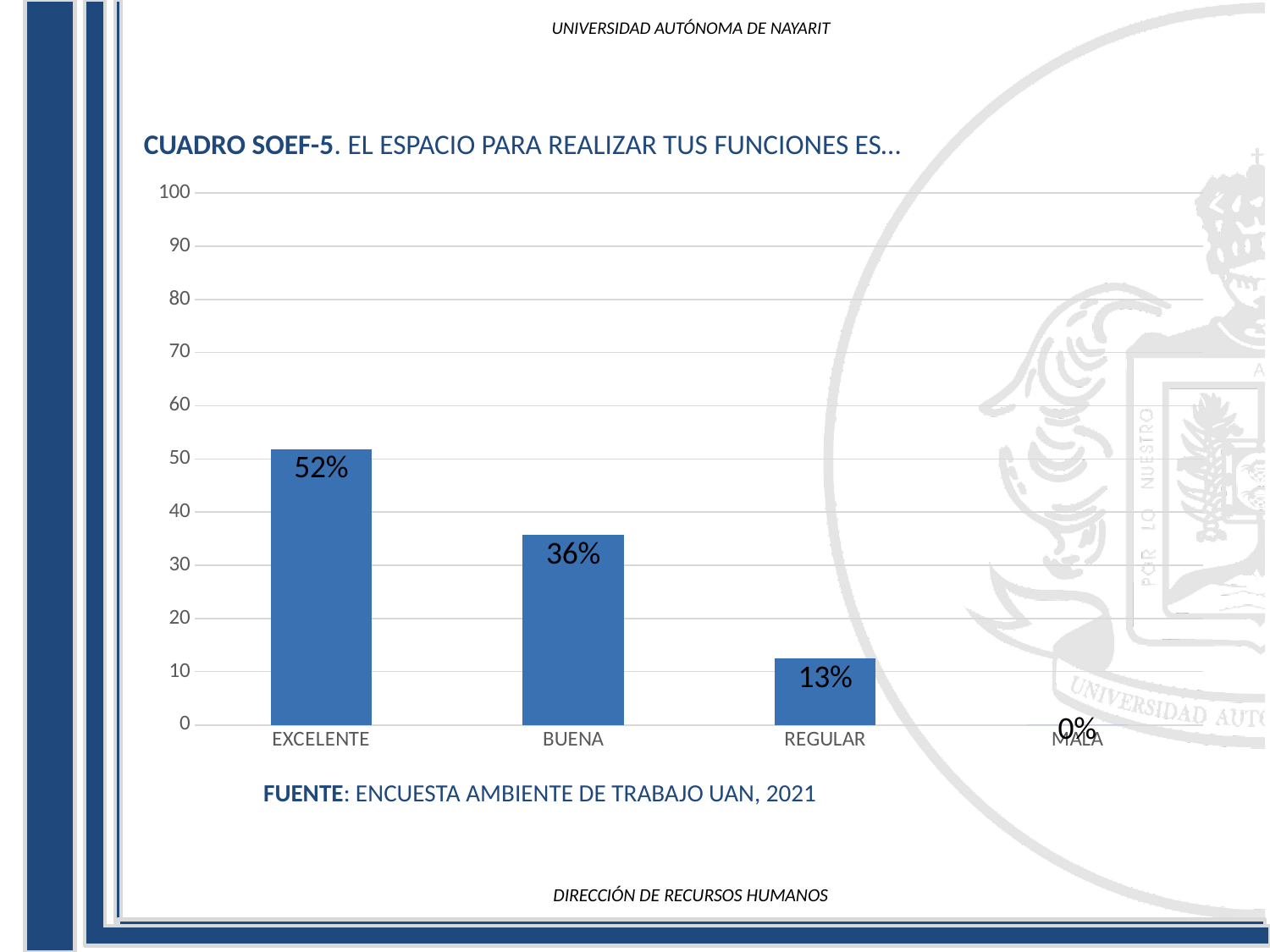
What kind of chart is shown on the slide? bar chart Which is larger, the value for BUENA or the value for REGULAR? BUENA Which category has the lowest value? MALA What is the value for BUENA? 36% What is the value for REGULAR? 13% What is the value for EXCELENTE? 52% Is the value for EXCELENTE greater or less than 50? greater How many categories are shown on the x axis? 4 What is the difference between the values for EXCELENTE and BUENA? 16% Which category has the highest value? EXCELENTE Do the values rise or fall from EXCELENTE to MALA along the x axis? fall What is the value for MALA? 0%